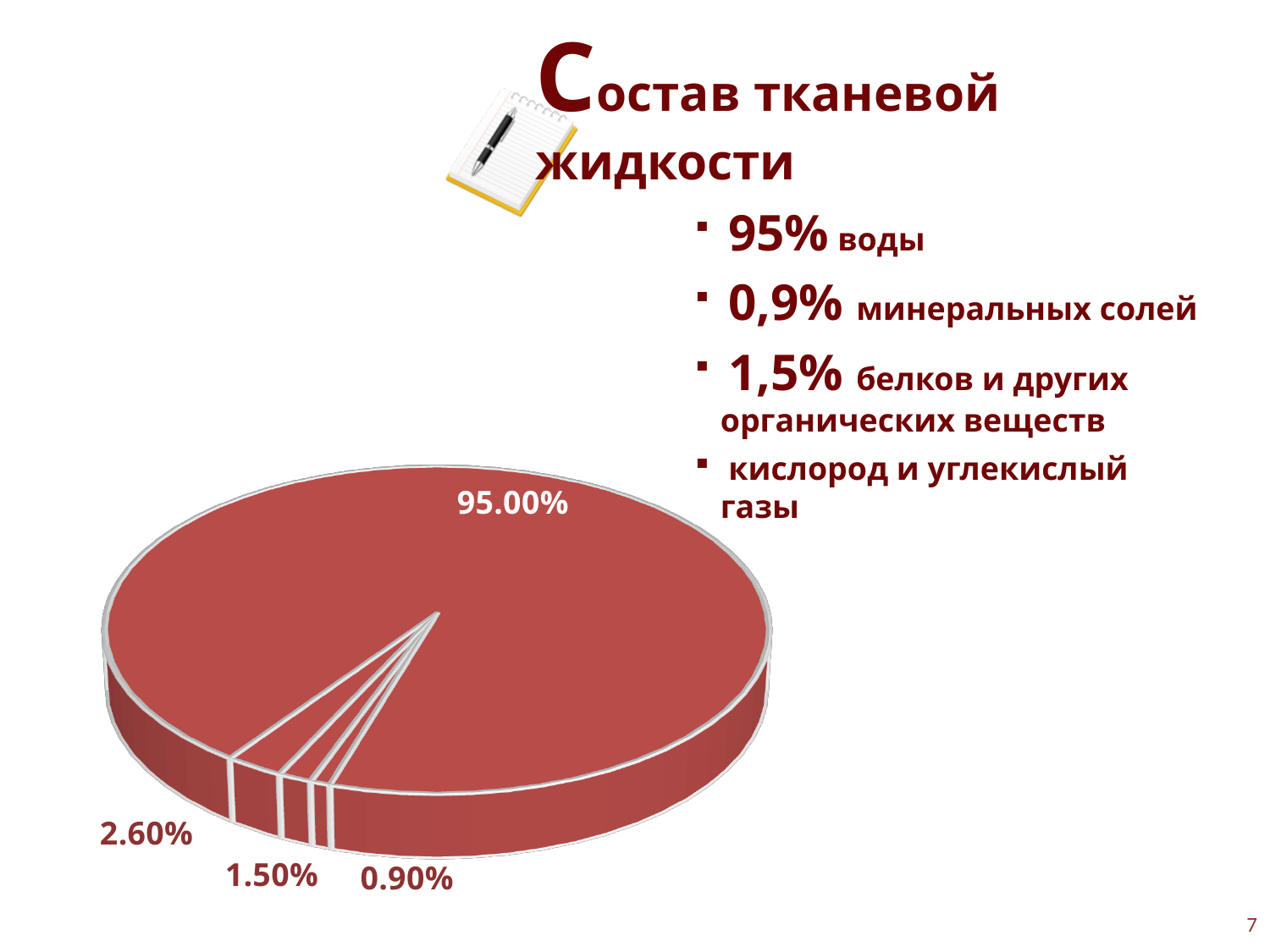
What is the title of the slide containing the pie chart? Состав тканевой жидкости What value is printed on the largest slice of the pie chart? 95.00% How many slices does the pie chart have? 4 What colour are the slices of the pie chart? red What kind of chart is shown on the slide? pie chart What do the four printed slice values add up to? 100.00% What is the smallest value printed on the pie chart? 0.90% What is the difference between the slices labelled 2.60% and 1.50%? 1.10% What is the difference between the slices labelled 1.50% and 0.90%? 0.60% Which is larger: the slice labelled 2.60% or the slice labelled 1.50%? 2.60% What share of the pie does the largest slice take? 95.00% What is the difference between the largest slice (95.00%) and the slice labelled 2.60%? 92.40%